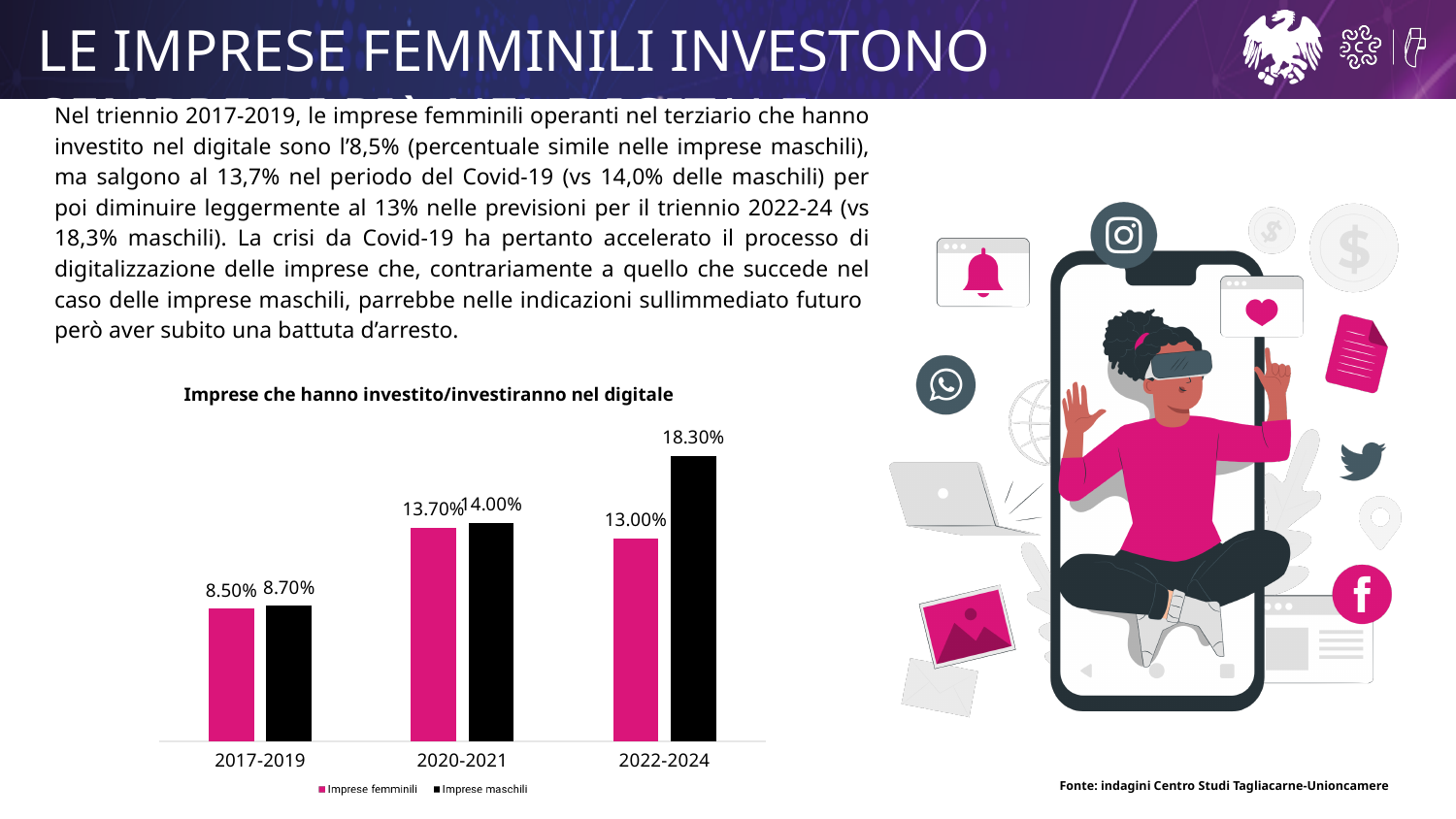
How many series does the chart legend list? 2 What is the title of the chart? Imprese che hanno investito/investiranno nel digitale What is the value for Imprese femminili in 2020-2021? 13.70% In which period is the value for Imprese femminili highest? 2020-2021 What is the value for Imprese maschili in 2022-2024? 18.30% Which is larger in 2022-2024, Imprese femminili or Imprese maschili? Imprese maschili What is the difference between Imprese maschili and Imprese femminili in 2022-2024? 5.30% What kind of chart is shown on the slide? Bar chart How many periods are shown on the x axis of the chart? 3 What is the value for Imprese maschili in 2017-2019? 8.70% In which period is the value for Imprese maschili lowest? 2017-2019 What is the value for Imprese femminili in 2017-2019? 8.50%